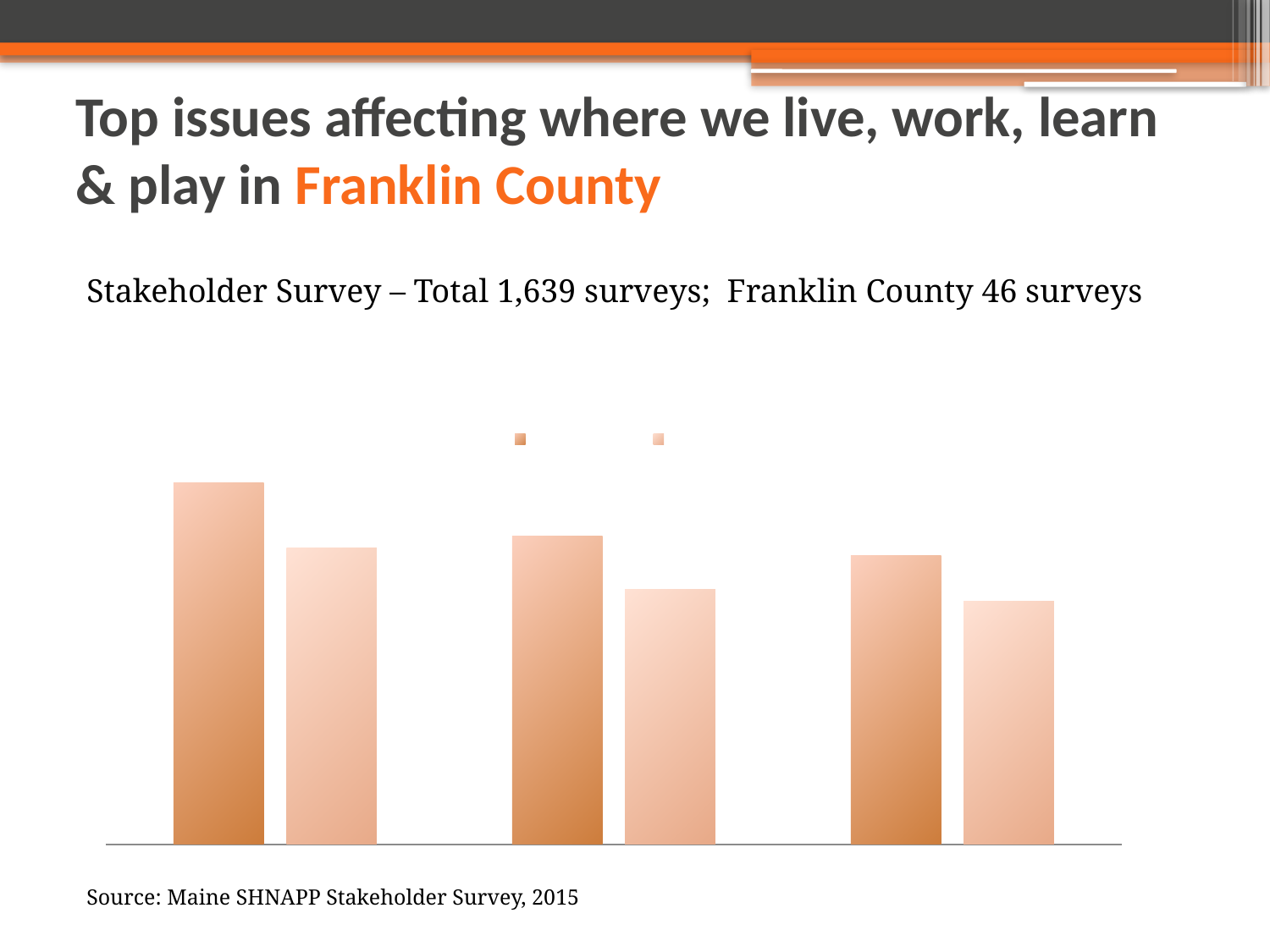
In the leftmost group of bars, is the darker bar or the lighter bar taller? the darker bar How many groups of bars are plotted in the chart? 3 Among the lighter bars, which group has the shortest bar: the left, middle or right group? the right group Do the darker bars rise or fall from left to right across the chart? fall What kind of chart is shown on the slide? bar chart What colour family are the bars in the chart? orange Do the lighter bars rise or fall from left to right across the chart? fall How many bars are plotted in total in the chart? 6 Are the bars in the chart vertical or horizontal? vertical How many series does the chart's legend list? 2 Among the darker bars, which group has the tallest bar: the left, middle or right group? the left group